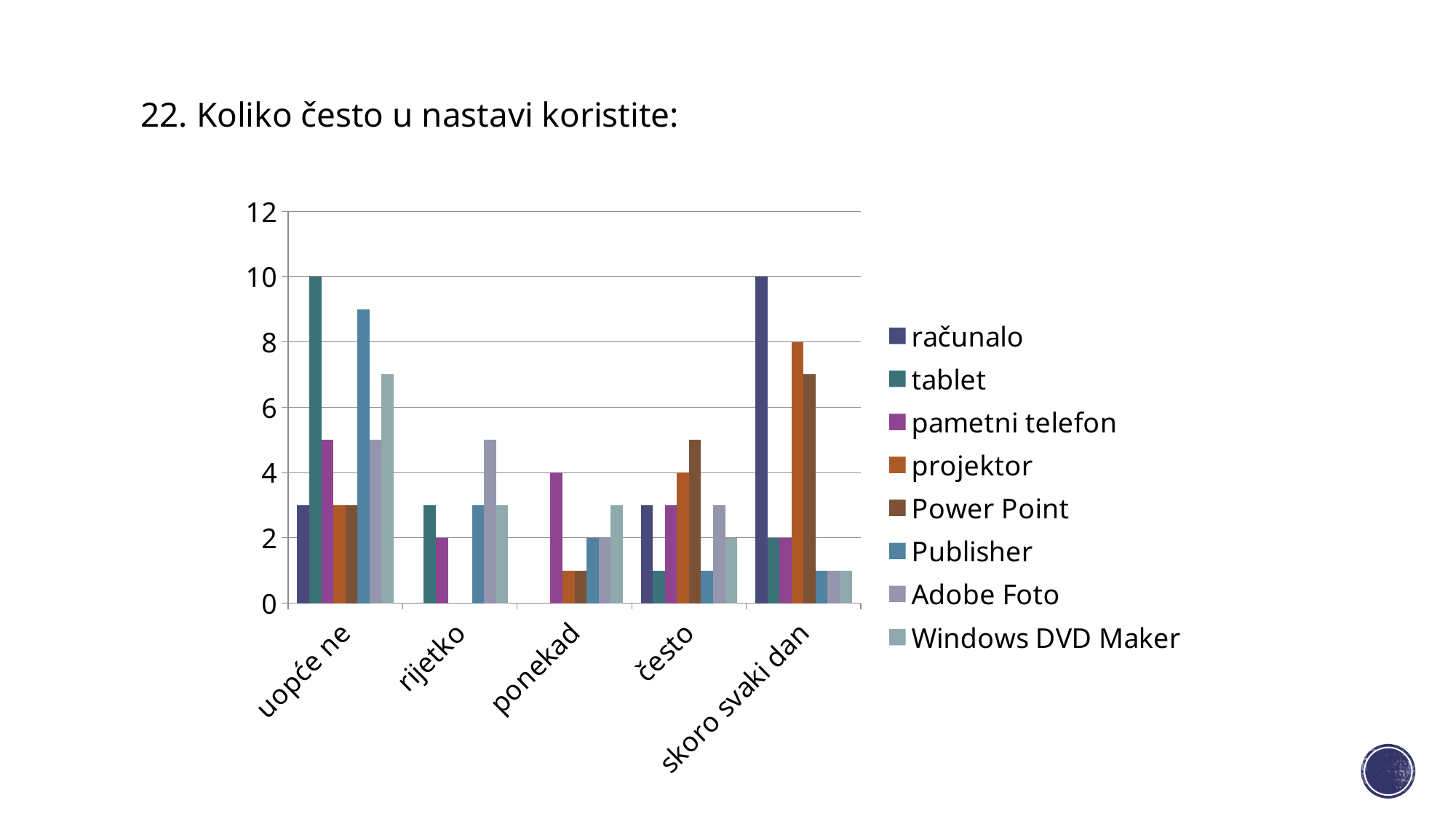
Is the value for Publisher in the 'uopće ne' category greater or less than 8? greater What is the title of the chart? 22. Koliko često u nastavi koristite: What is the value for pametni telefon in the 'ponekad' category? 4 How many series does the legend list? 8 What kind of chart is shown on the slide? bar chart What is the value for tablet in the 'uopće ne' category? 10 What is the value for računalo in the 'skoro svaki dan' category? 10 In which category is the bar for računalo the tallest? skoro svaki dan How many categories are shown on the x axis? 5 Is the value for Windows DVD Maker in the 'uopće ne' category greater or less than 6? greater In the 'skoro svaki dan' category, which is larger: the value for računalo or the value for projektor? računalo What is the value for projektor in the 'skoro svaki dan' category? 8